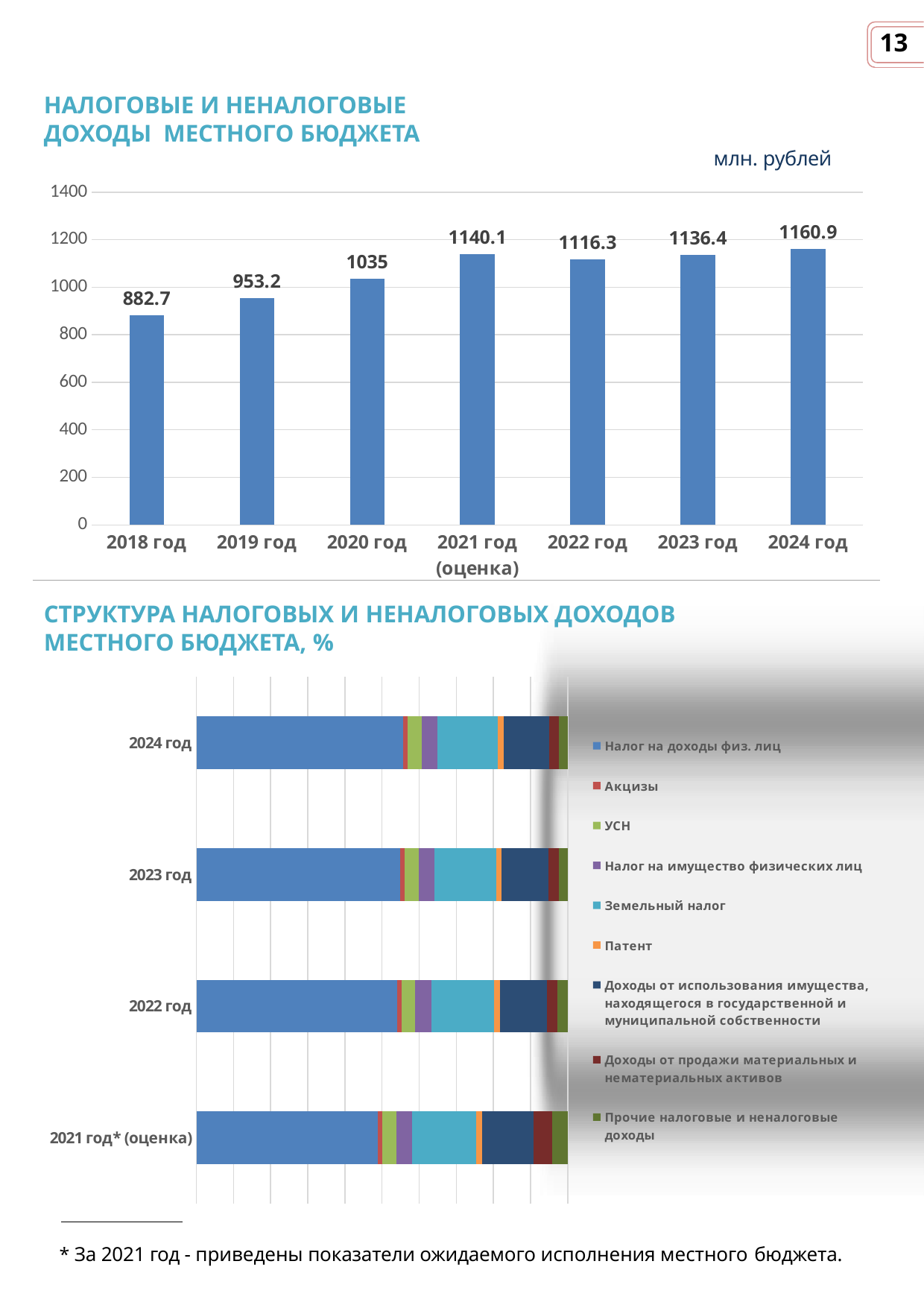
On the top chart 'Налоговые и неналоговые доходы местного бюджета', what is the difference between the values for 2020 год and 2019 год? 81.8 On the top chart 'Налоговые и неналоговые доходы местного бюджета', which is larger: the value for 2021 год (оценка) or 2022 год? 2021 год (оценка) On the bottom chart 'Структура налоговых и неналоговых доходов местного бюджета, %', how many years are shown? 4 On the top chart 'Налоговые и неналоговые доходы местного бюджета', what is the value for 2024 год? 1160.9 On the top chart 'Налоговые и неналоговые доходы местного бюджета', what is the value for 2018 год? 882.7 What kind of chart is the bottom chart 'Структура налоговых и неналоговых доходов местного бюджета, %'? Stacked bar chart On the top chart 'Налоговые и неналоговые доходы местного бюджета', what unit is stated for the values? млн. рублей On the top chart 'Налоговые и неналоговые доходы местного бюджета', what is the value for 2021 год (оценка)? 1140.1 On the bottom chart 'Структура налоговых и неналоговых доходов местного бюджета, %', how many series does the legend list? 9 On the top chart 'Налоговые и неналоговые доходы местного бюджета', how many years are shown? 7 On the top chart 'Налоговые и неналоговые доходы местного бюджета', which year has the highest value? 2024 год On the top chart 'Налоговые и неналоговые доходы местного бюджета', which year has the lowest value? 2018 год